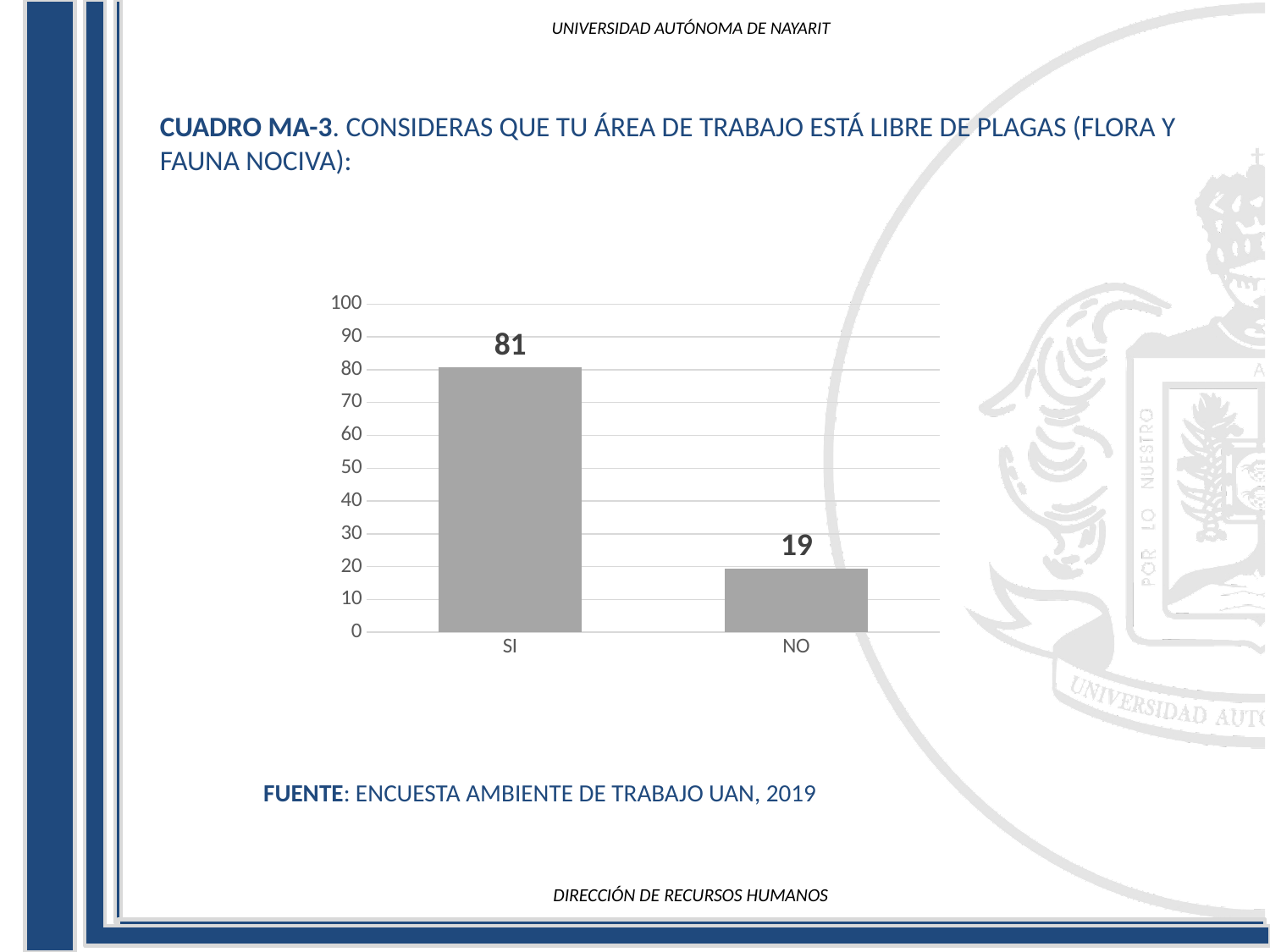
Is the value for NO greater or less than 30? less Which is larger, the value for SI or the value for NO? SI What is the difference between the values for SI and NO? 62 Is the value for SI greater or less than 50? greater Which category has the highest value? SI Which category has the lowest value? NO What is the value for SI? 81 What is the highest value shown on the vertical axis? 100 What kind of chart is shown on the slide? bar chart What is the total of the values for SI and NO? 100 How many categories are shown on the x axis? 2 What is the value for NO? 19